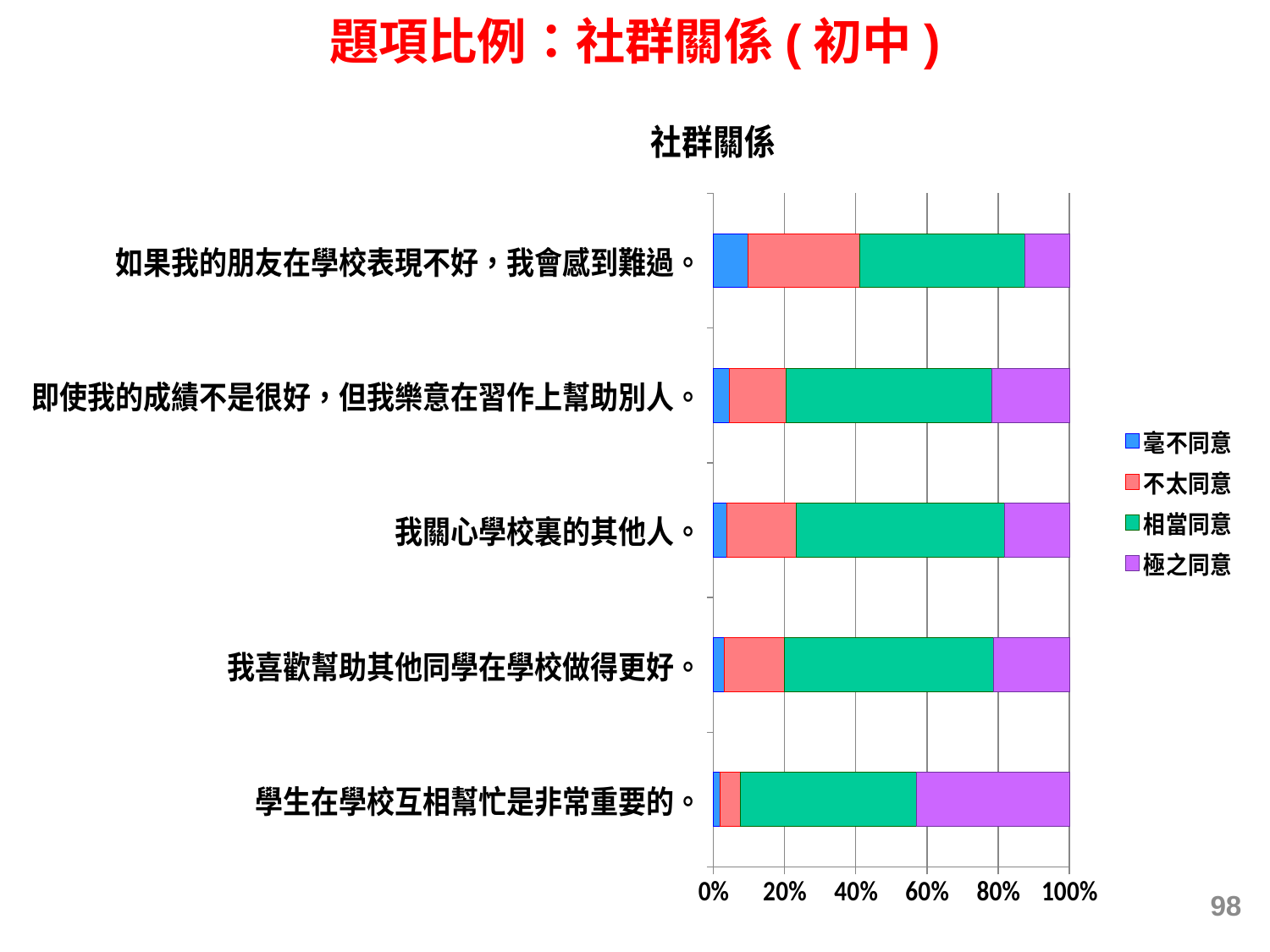
What is the total of each stacked bar in the chart? 100% Is the 極之同意 share for 如果我的朋友在學校表現不好，我會感到難過 greater or less than 20%? less How many statements (categories) are plotted in the 社群關係 chart? 5 Which statement has the largest 極之同意 segment? 學生在學校互相幫忙是非常重要的。 Which statement has the smallest 不太同意 segment? 學生在學校互相幫忙是非常重要的。 What is the title of the chart? 社群關係 How many series does the legend of the 社群關係 chart list? 4 Which legend entry is shown in purple? 極之同意 Is the 極之同意 share for 學生在學校互相幫忙是非常重要的 greater or less than 40%? greater Which statement has the largest 毫不同意 segment? 如果我的朋友在學校表現不好，我會感到難過。 Which statement has a larger 極之同意 segment: 學生在學校互相幫忙是非常重要的 or 如果我的朋友在學校表現不好，我會感到難過? 學生在學校互相幫忙是非常重要的。 What kind of chart is shown on the slide? Stacked bar chart